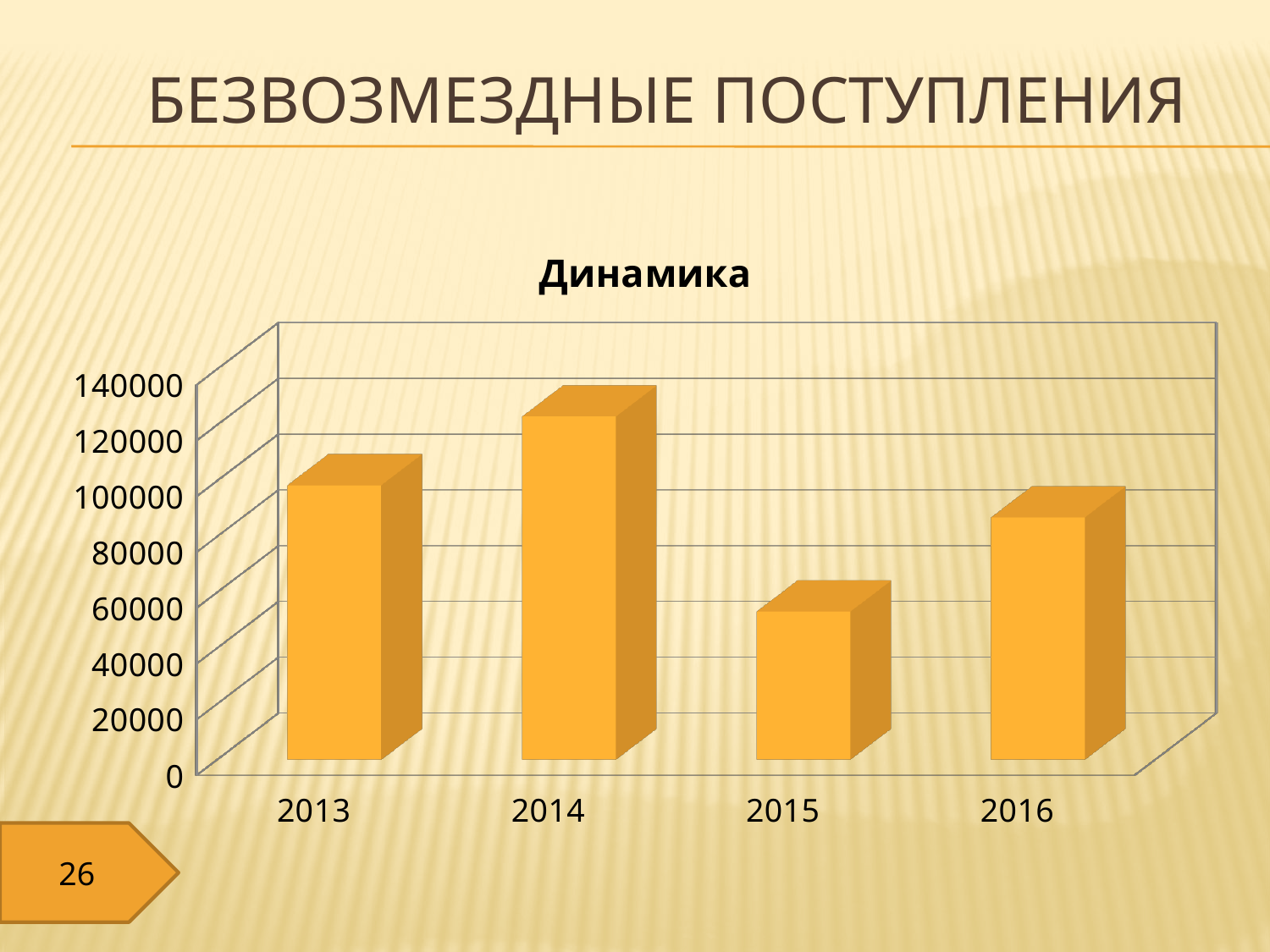
Which year has the larger value, 2014 or 2015? 2014 Which year has the lowest bar in the chart? 2015 Is the value for 2016 greater or less than 120000? less Is the value for 2014 greater or less than 100000? greater How many years are shown on the x axis of the chart? 4 Which year has the highest bar in the chart? 2014 What is the title of the chart? Динамика Which year has the larger value, 2013 or 2016? 2013 Is the value for 2013 greater or less than 80000? greater Does the value rise or fall from 2014 to 2015? fall What kind of chart is shown on the slide? bar chart